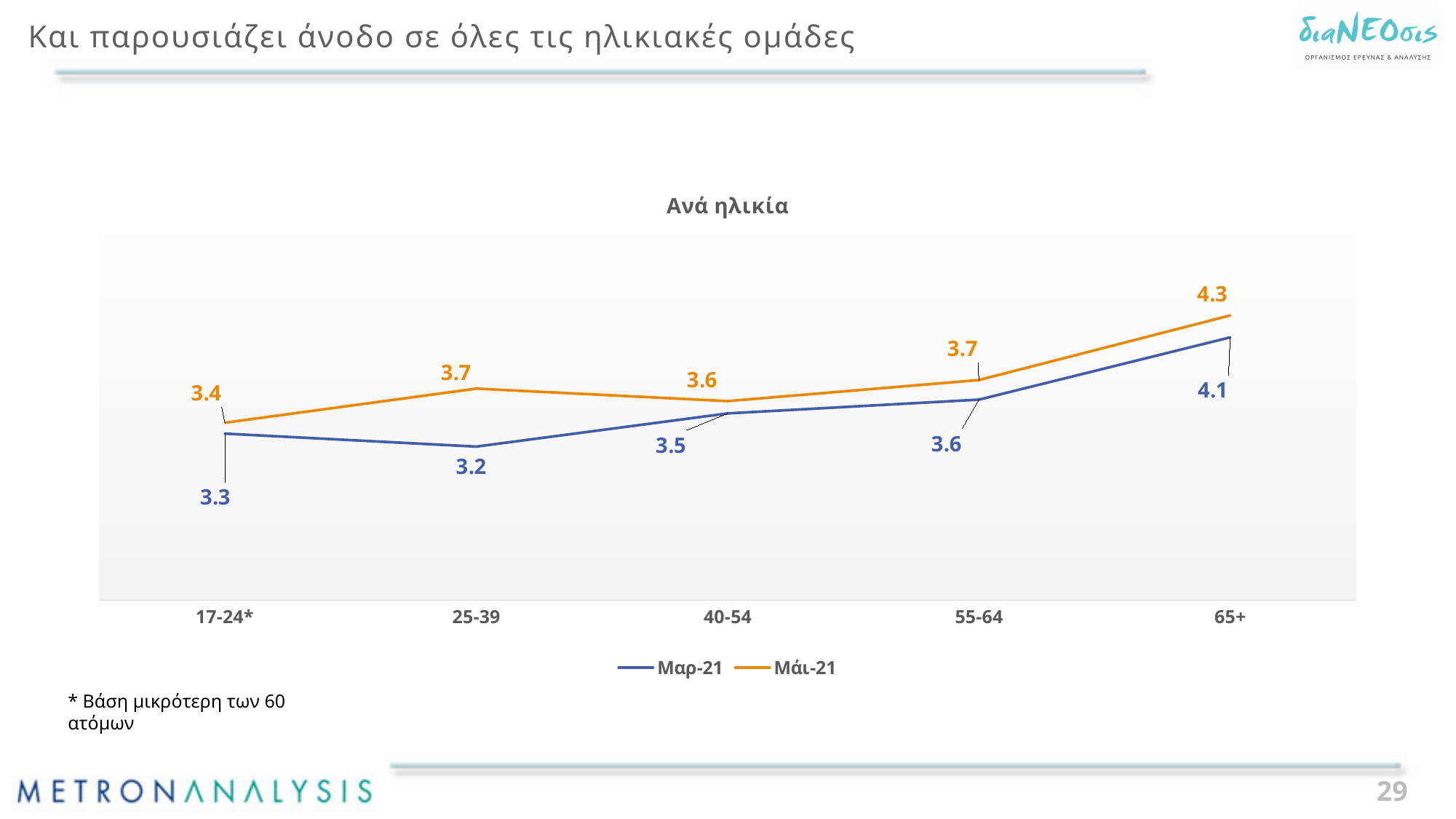
What is the Μαρ-21 value for the 40-54 age group? 3.5 How many series does the legend list? 2 For the 55-64 age group, which series has the larger value, Μαρ-21 or Μάι-21? Μάι-21 How many age groups are shown on the x axis? 5 What is the title of the chart? Ανά ηλικία What type of chart is shown on the slide? line chart What is the Μάι-21 value for the 25-39 age group? 3.7 What is the Μάι-21 value for the 65+ age group? 4.3 What is the difference between the Μάι-21 and Μαρ-21 values for the 25-39 age group? 0.5 Does the Μάι-21 line rise or fall between the 55-64 and 65+ age groups? rise Which age group has the highest Μαρ-21 value? 65+ Which age group has the lowest Μαρ-21 value? 25-39